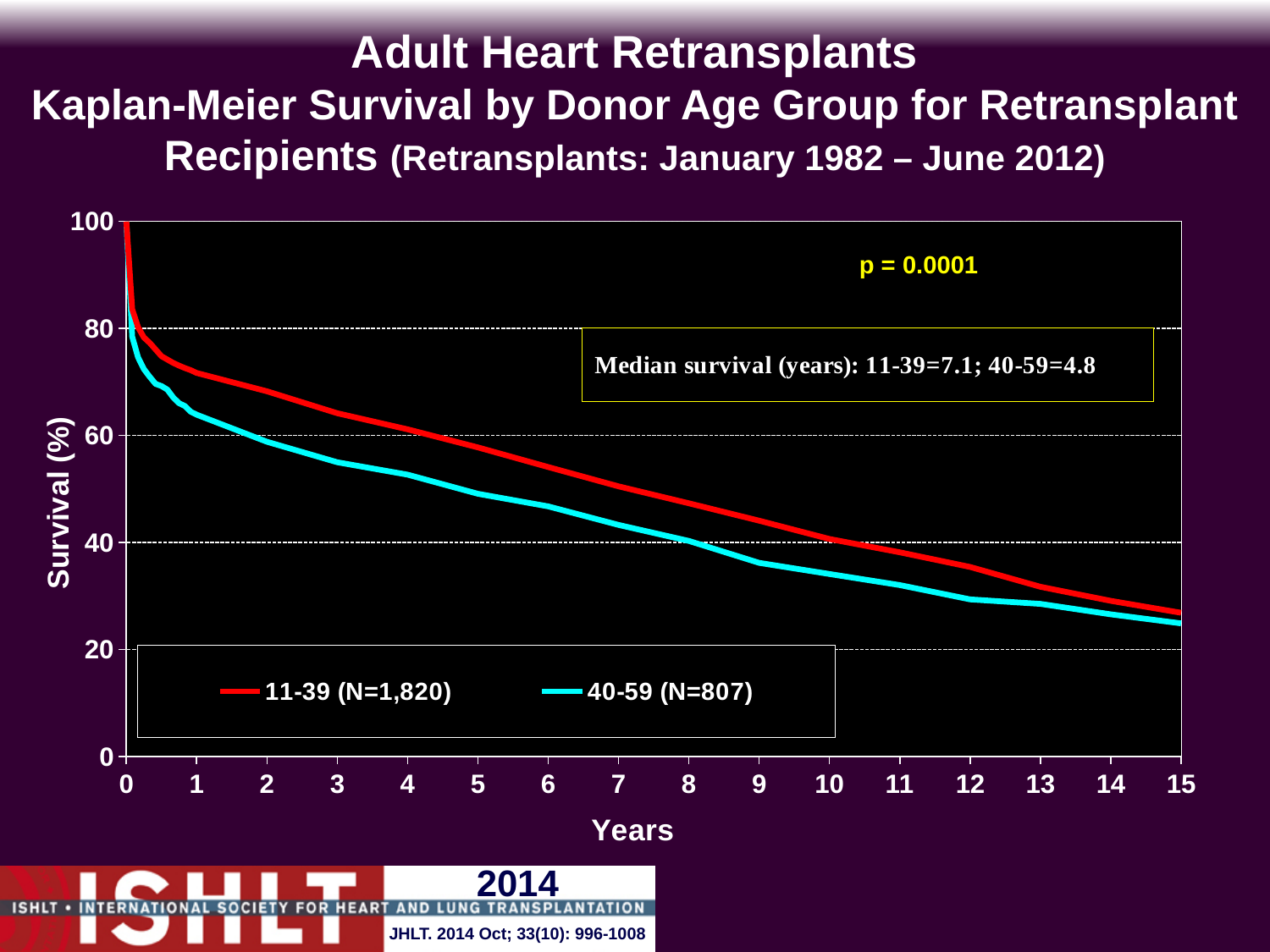
Which donor age group has the higher median survival? 11-39 What is the N for the 11-39 donor age group shown in the legend? 1,820 What kind of chart is shown on the slide? Line chart What p-value is shown on the chart? p = 0.0001 Do the survival curves rise or fall as years increase? Fall What is the median survival in years for the 11-39 donor age group? 7.1 How many series does the legend list? 2 Is the survival value for the 11-39 group at 1 year greater or less than 60? greater What is the median survival in years for the 40-59 donor age group? 4.8 Is the survival value for the 40-59 group at 10 years greater or less than 40? less What is the difference in median survival (years) between the 11-39 and 40-59 donor age groups? 2.3 Which donor age group has the lower survival curve across the years shown? 40-59